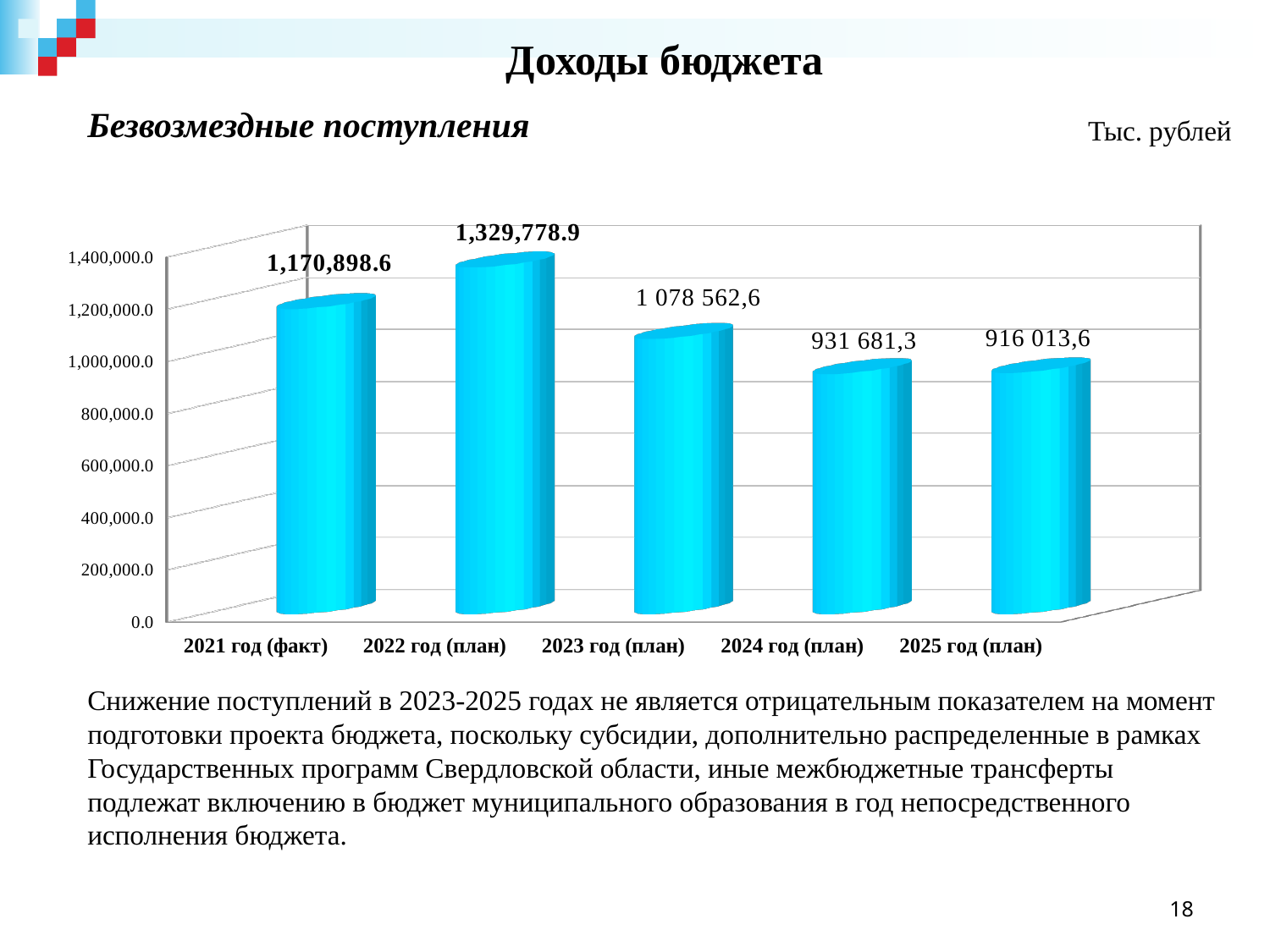
What is the value for 2021 год (факт)? 1,170,898.6 What is the value for 2023 год (план)? 1 078 562,6 Which is larger, the value for 2024 год (план) or 2025 год (план)? 2024 год (план) What is the value for 2025 год (план)? 916 013,6 What is the value for 2022 год (план)? 1,329,778.9 What kind of chart is shown on the slide? bar chart Is the value for 2024 год (план) greater or less than 1,000,000.0? less Which year has the highest value? 2022 год (план) Do the values rise or fall from 2022 год (план) to 2025 год (план)? fall What is the difference between the values for 2022 год (план) and 2021 год (факт)? 158,880.3 Which year has the lowest value? 2025 год (план) How many years are shown on the chart? 5